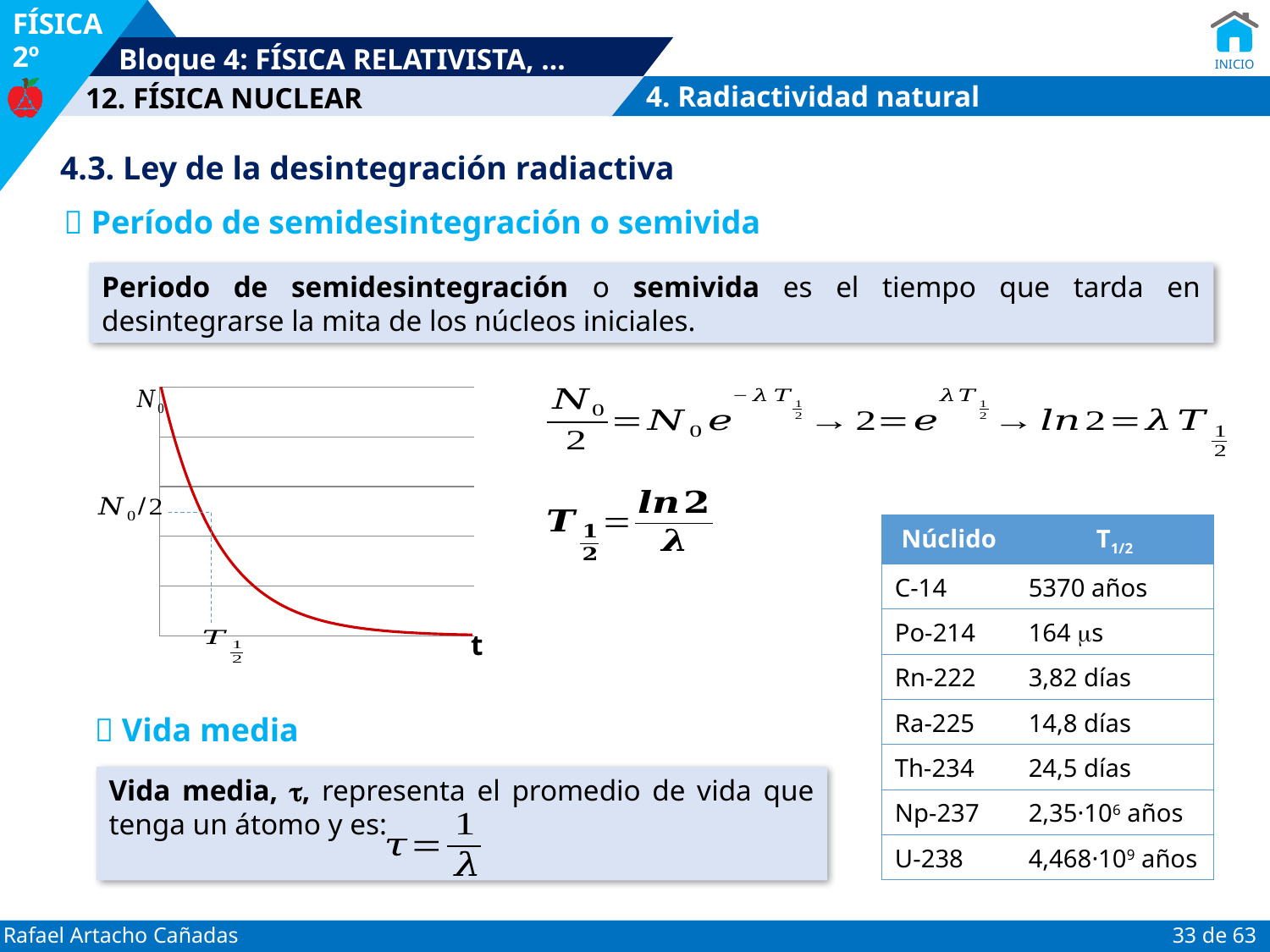
In the chart on the left, what is the value of the curve at t = 0? N0 What kind of chart is shown on the left of the slide? line chart How many curves are plotted in the chart on the left? 1 What is the label on the vertical axis of the chart on the left? N In the chart on the left, what time on the horizontal axis does the dashed line mark? T1/2 In the chart on the left, is the value of the curve at T1/2 greater or less than N0? less What is the label on the horizontal axis of the chart on the left? t In the chart on the left, does the curve rise or fall as t increases? fall In the chart on the left, what value on the vertical axis does the dashed line mark? N0/2